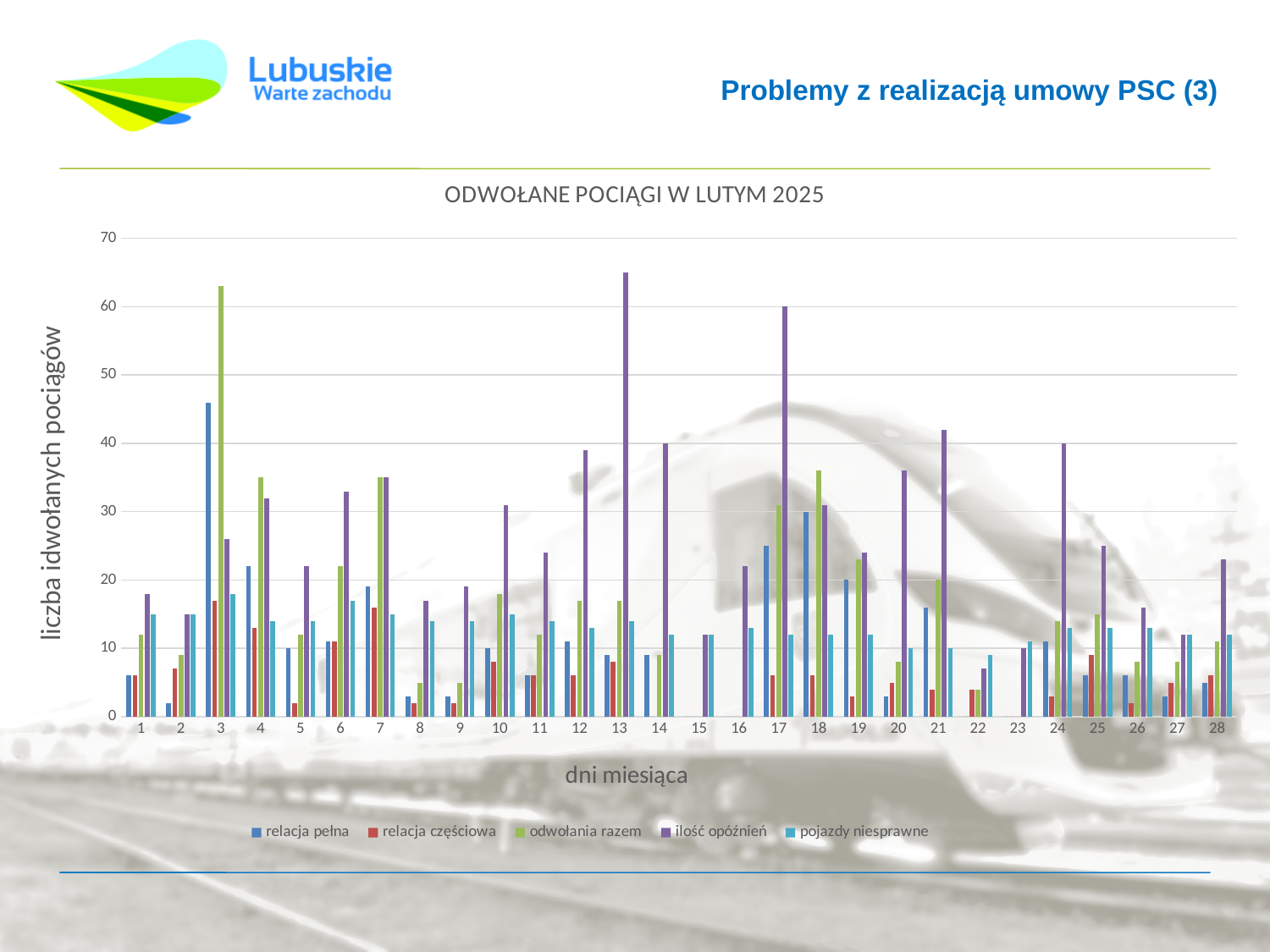
Is the value for 'relacja pełna' on day 3 greater or less than 50? less How many series does the legend list? 5 Is the value for 'ilość opóźnień' on day 13 greater or less than 60? greater On which day is the value for 'relacja pełna' the highest? 3 What is the label of the x axis? dni miesiąca Which is larger: the value for 'relacja pełna' on day 3 or on day 17? day 3 On which day is the value for 'odwołania razem' the highest? 3 How many days (categories) are shown on the x axis? 28 Is the value for 'odwołania razem' on day 18 greater or less than 30? greater What is the title of the chart? ODWOŁANE POCIĄGI W LUTYM 2025 On which day is the value for 'ilość opóźnień' the highest? 13 What kind of chart is shown on the slide? bar chart